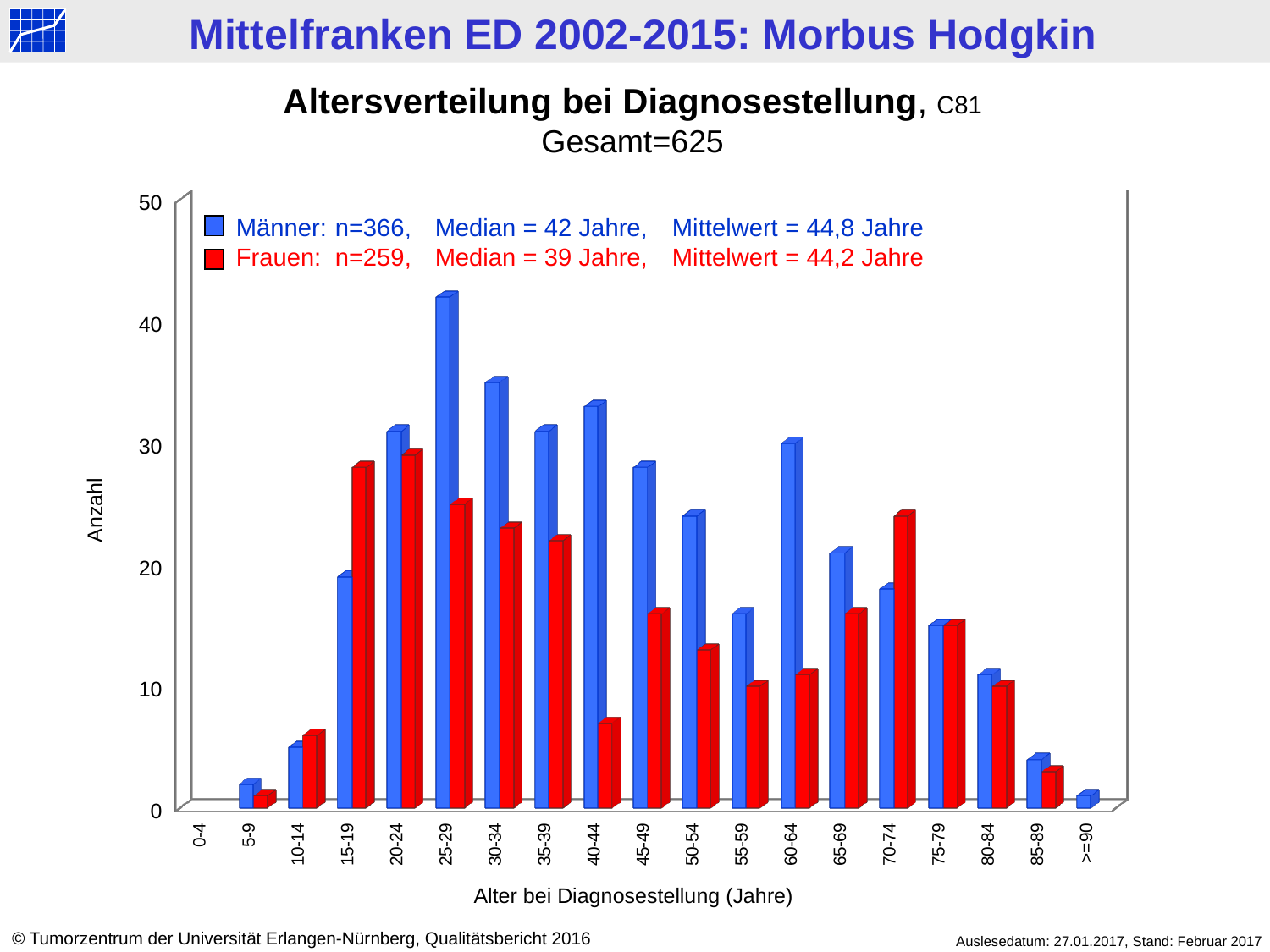
According to the legend, what is the median age for Frauen? 39 Jahre Is the Frauen value for the 40-44 age group greater or less than 10? less In the 15-19 age group, which series has the larger value, Männer or Frauen? Frauen What kind of chart is shown on the slide? bar chart How many series does the legend list? 2 Is the Männer value for the 25-29 age group greater or less than 40? greater According to the legend, what is the n for Männer? n=366 Is the Männer value for the 30-34 age group greater or less than 30? greater Which age group has the highest value for Männer? 25-29 In the 70-74 age group, which series has the larger value, Männer or Frauen? Frauen How many age groups are shown on the x axis? 19